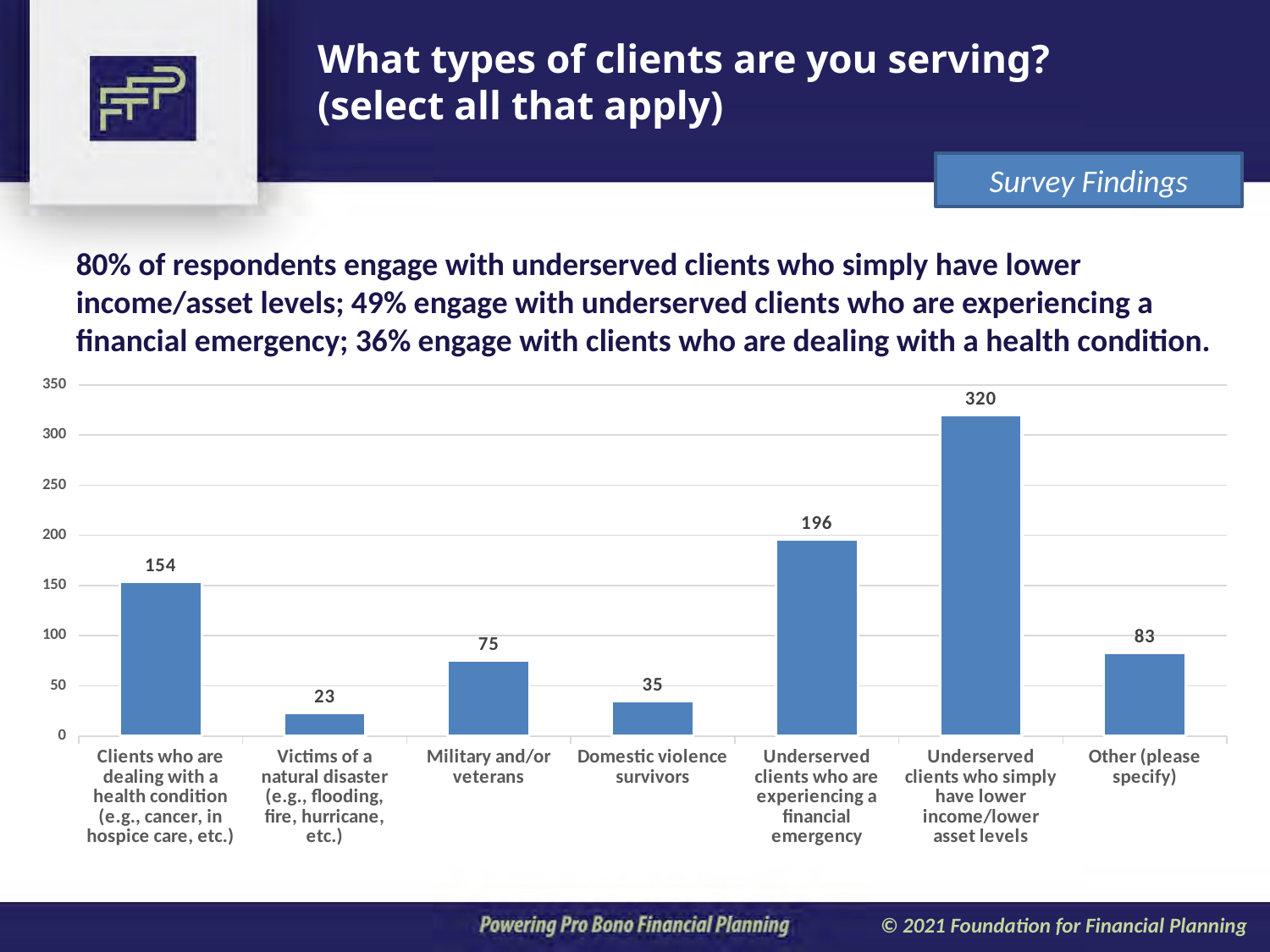
What is the difference between the values for Clients who are dealing with a health condition and Other (please specify)? 71 What is the value for Other (please specify)? 83 Is the value for Clients who are dealing with a health condition greater or less than 100? greater What is the difference between the values for Underserved clients who simply have lower income/lower asset levels and Underserved clients who are experiencing a financial emergency? 124 Which is larger, the value for Military and/or veterans or the value for Other (please specify)? Other (please specify) What is the value for Domestic violence survivors? 35 Which category has the highest value? Underserved clients who simply have lower income/lower asset levels Which category has the lowest value? Victims of a natural disaster (e.g., flooding, fire, hurricane, etc.) What is the value for Military and/or veterans? 75 What is the highest value shown on the y axis? 350 How many categories are shown on the x axis? 7 What kind of chart is shown on the slide? bar chart